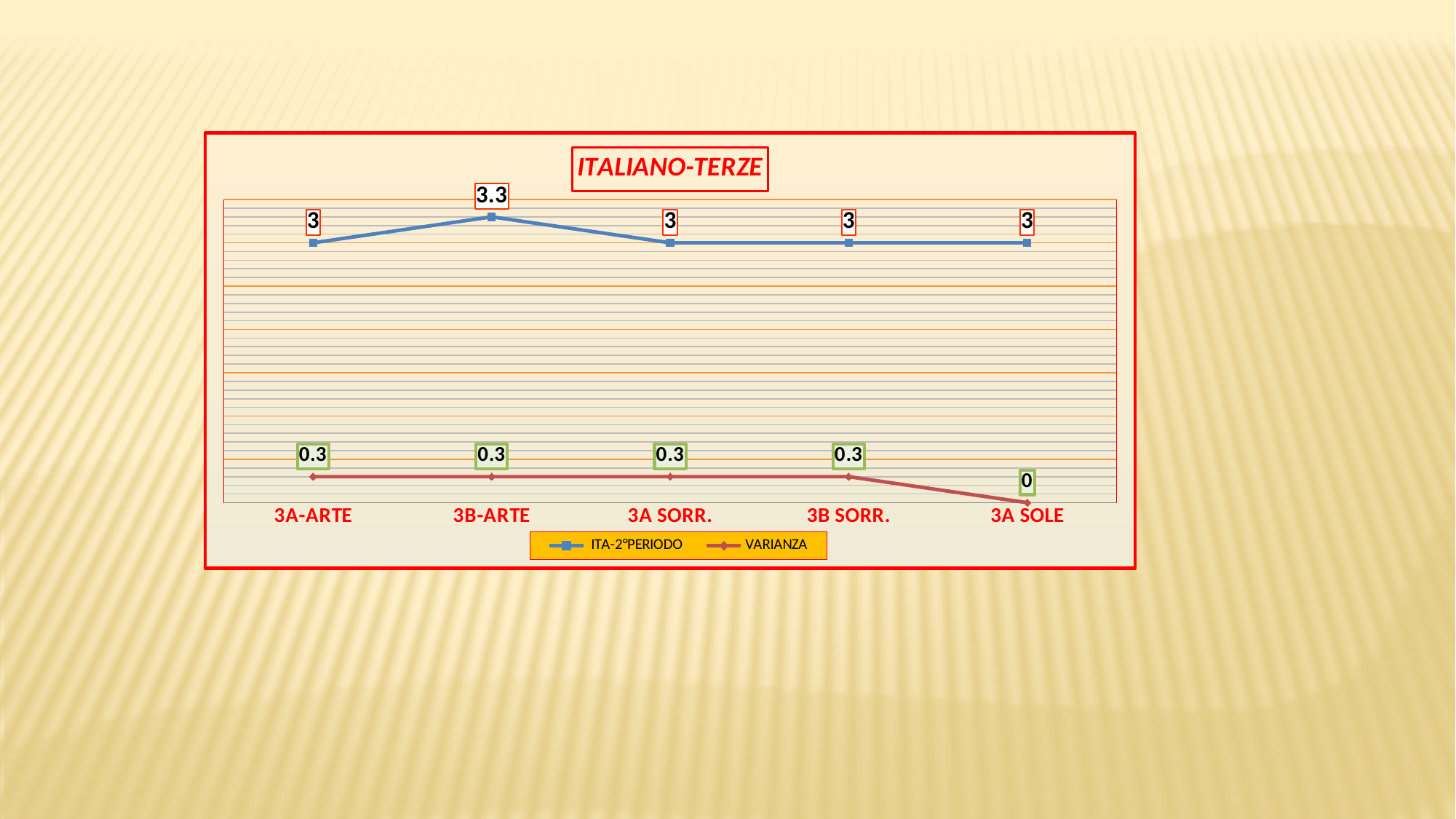
How many categories are shown on the x axis? 5 What is the VARIANZA value for 3A SORR.? 0.3 What is the ITA-2°PERIODO value for 3A SOLE? 3 Which category has the lowest VARIANZA value? 3A SOLE What is the title of the chart? ITALIANO-TERZE What is the difference between the ITA-2°PERIODO values for 3B-ARTE and 3A-ARTE? 0.3 What kind of chart is shown on the slide? Line chart What is the VARIANZA value for 3A SOLE? 0 What is the ITA-2°PERIODO value for 3B-ARTE? 3.3 Which is larger, the ITA-2°PERIODO value for 3B-ARTE or for 3A SORR.? 3B-ARTE Which category has the highest ITA-2°PERIODO value? 3B-ARTE How many series does the legend list? 2